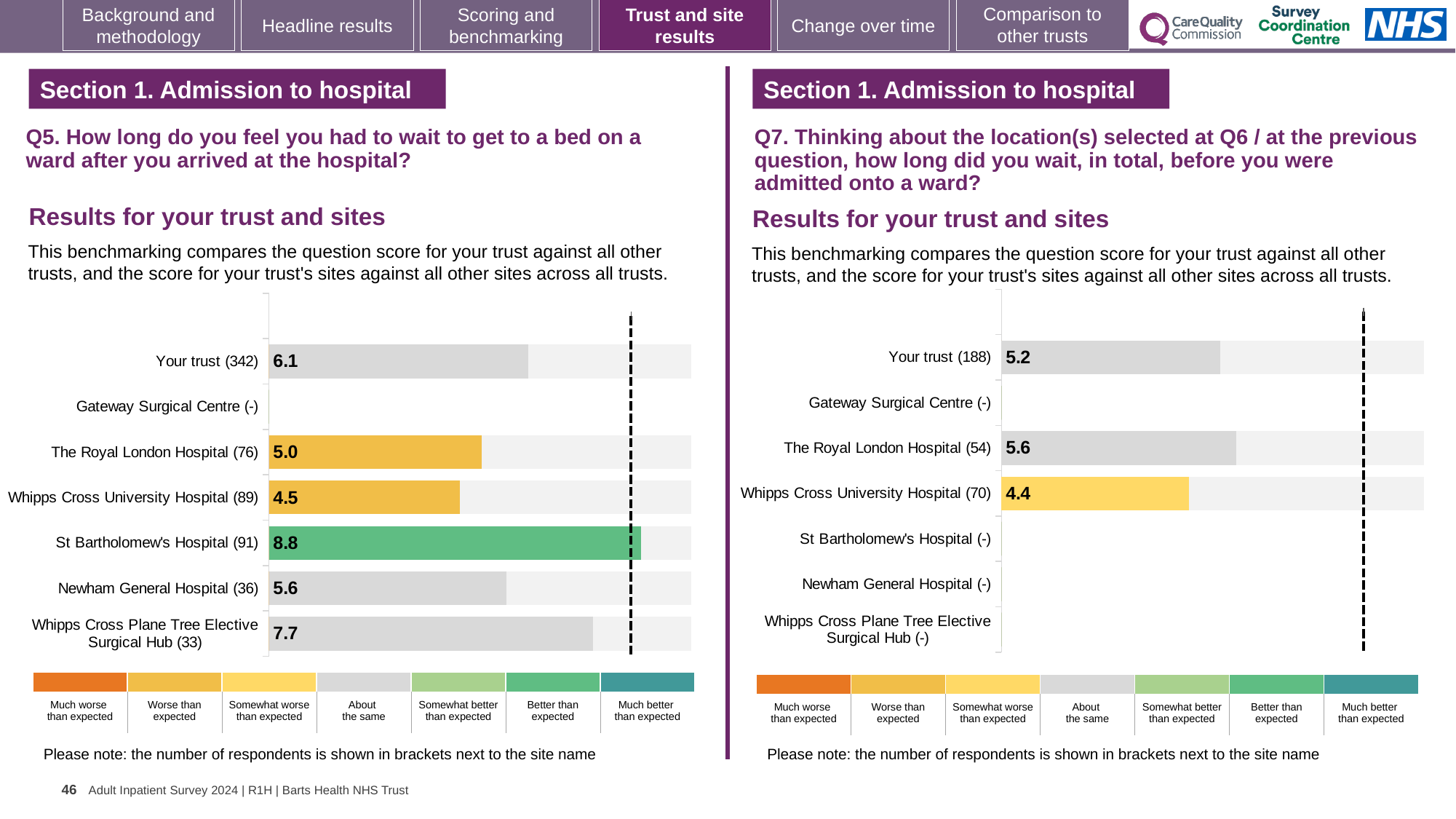
On the Q7 chart (right), what is the score for Whipps Cross University Hospital? 4.4 On the Q5 chart (left), which site has the lowest score? Whipps Cross University Hospital On the Q5 chart (left), which has the higher score: Newham General Hospital or The Royal London Hospital? Newham General Hospital On the Q5 chart (left), what is the difference between the scores for St Bartholomew's Hospital and Whipps Cross University Hospital? 4.3 On the Q5 chart (left), how many site rows are listed, including Your trust? 7 What kind of chart is used on the Q7 chart (right)? Bar chart On the Q5 chart (left), which site has the highest score? St Bartholomew's Hospital On the Q5 chart (left), what is the score for Your trust? 6.1 On the Q5 chart (left), what colour is the bar for St Bartholomew's Hospital? Green On the Q5 chart (left), what is the score for St Bartholomew's Hospital? 8.8 On the Q7 chart (right), what is the difference between the scores for The Royal London Hospital and Your trust? 0.4 On the Q7 chart (right), what is the score for The Royal London Hospital? 5.6